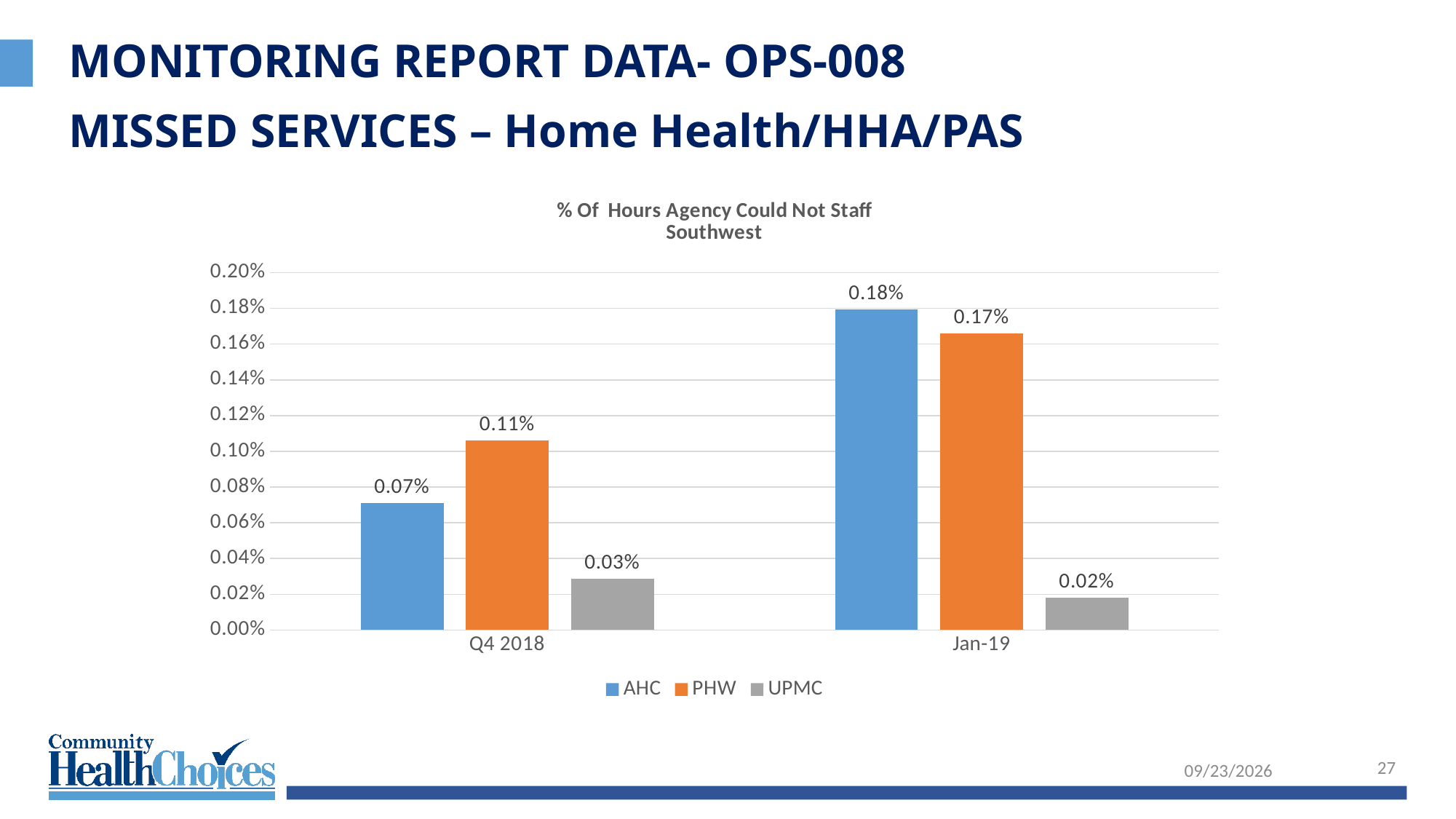
How many time periods are shown on the x axis? 2 What is the value for PHW in Jan-19? 0.17% Which series has the highest value in Jan-19? AHC How many series does the legend list? 3 What is the value for UPMC in Q4 2018? 0.03% Does the UPMC value rise or fall from Q4 2018 to Jan-19? Fall What kind of chart is shown on the slide? Bar chart Which is larger in Q4 2018, the AHC value or the PHW value? PHW Which series has the lowest value in Q4 2018? UPMC What is the value for AHC in Q4 2018? 0.07% Is the value for AHC in Jan-19 greater or less than 0.10%? greater What is the difference between the PHW value in Jan-19 and the PHW value in Q4 2018? 0.06%